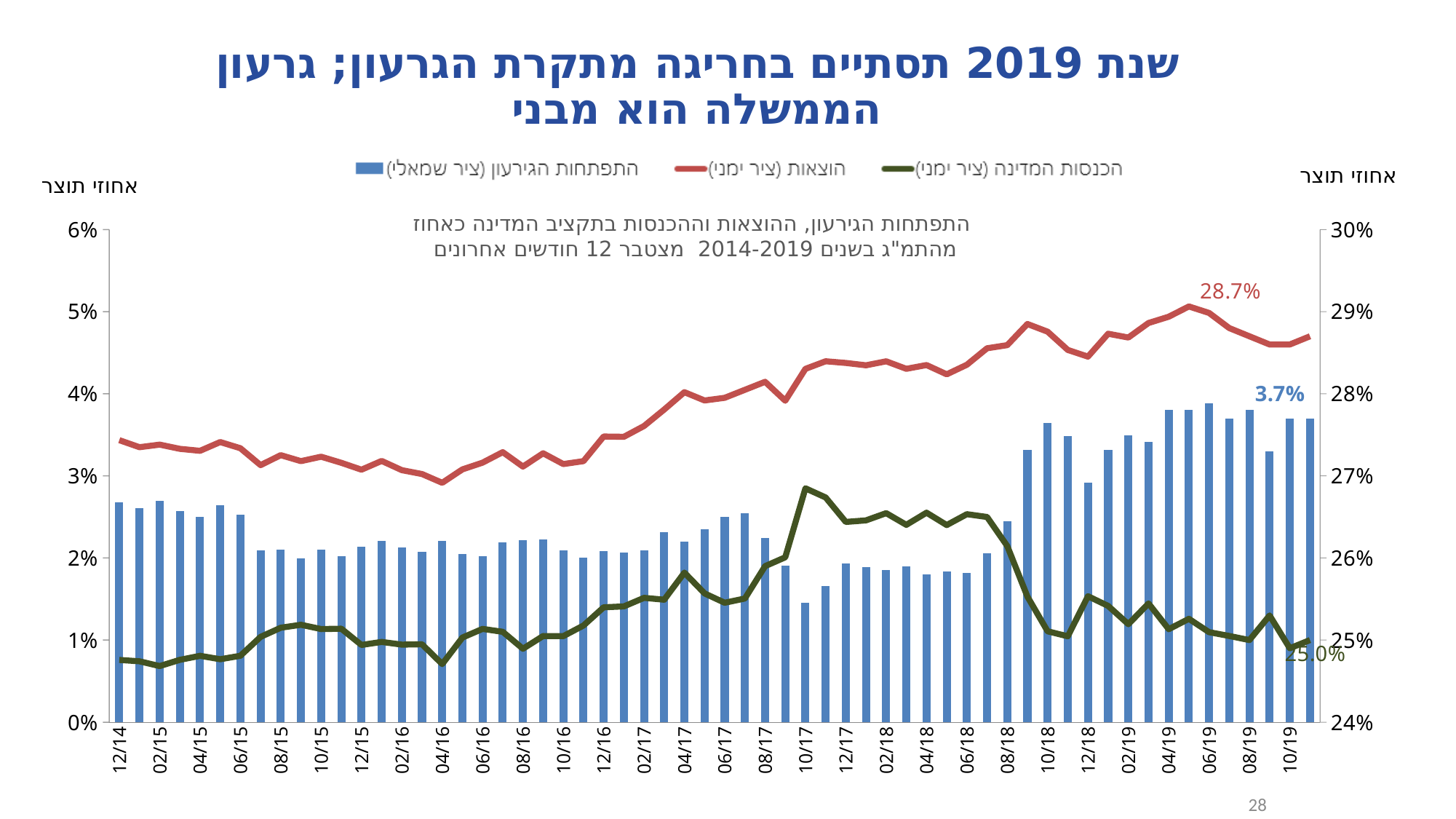
Which axis does the deficit (התפתחות הגירעון) series use according to the legend? Left axis (ציר שמאלי) What is the labelled value of the expenditures (הוצאות) line at the end of the series? 28.7% How many series does the legend list? 3 What kind of chart is shown on the slide? Combined bar and line chart Is the deficit bar for 10/17 greater or less than 2% on the left axis? less Is the expenditures (הוצאות) line at 12/14 greater or less than 27% on the right axis? greater Is the deficit bar for 12/14 greater or less than 2% on the left axis? greater What is the labelled value of the deficit (התפתחות הגירעון) bar at the end of the series? 3.7% Which deficit bar is taller, 10/17 or 10/18? 10/18 What is the labelled value of the state revenues (הכנסות המדינה) line at the end of the series? 25.0% Does the expenditures (הוצאות) line generally rise or fall from 12/14 to 10/19? rise